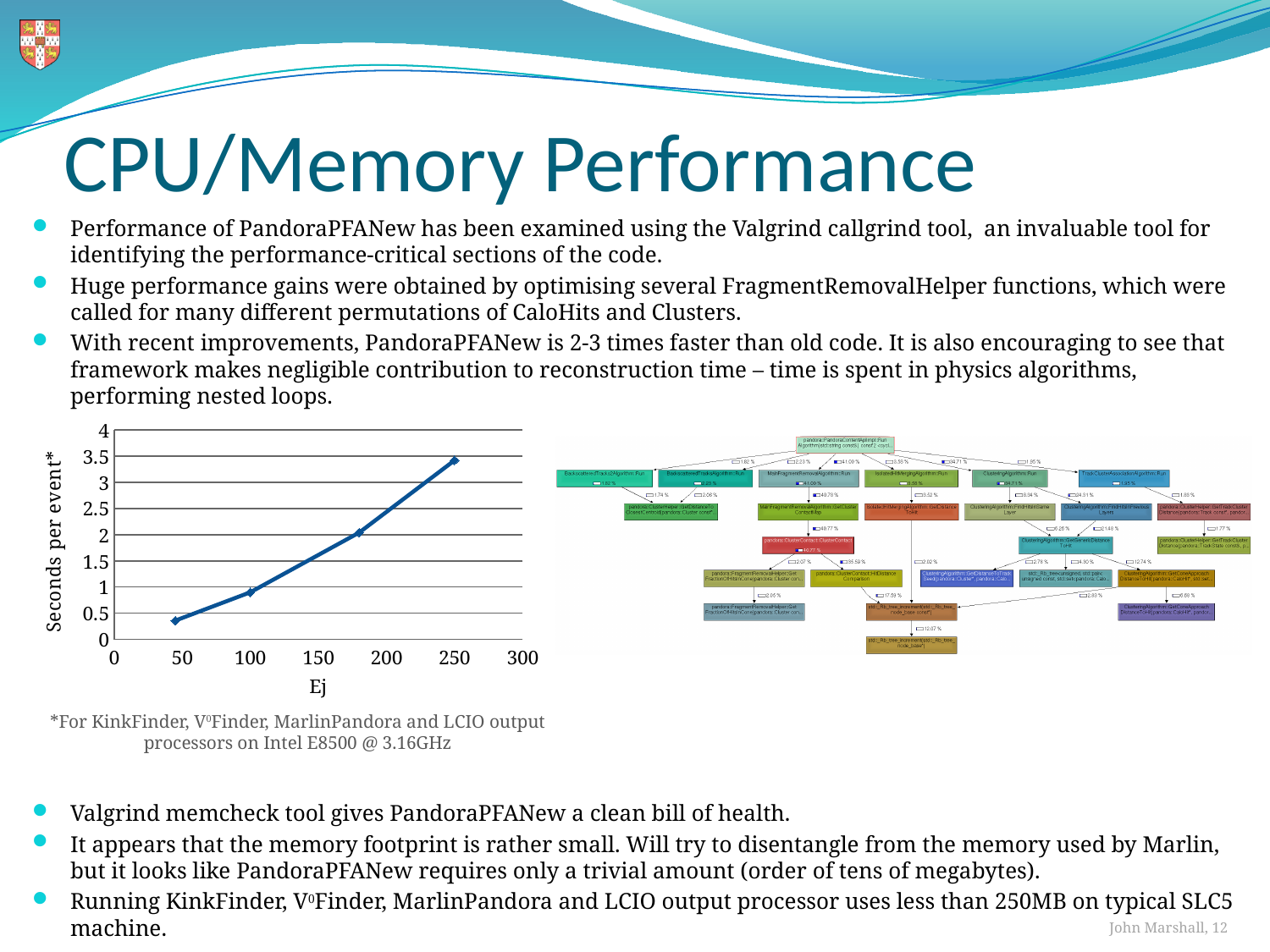
What is the label on the y axis of the left chart? Seconds per event* What kind of chart is the chart on the left of the slide (Seconds per event* vs Ej)? line chart In the left chart, is the value for the point near Ej = 100 greater or less than 1.5? less What is the label on the x axis of the left chart? Ej In the left chart, is the value for the point near Ej = 50 greater or less than 1? less In the left chart, which point has the highest Seconds per event value, the one near Ej = 50 or the one near Ej = 250? the one near Ej = 250 In the left chart, is the value for the point near Ej = 250 greater or less than 3? greater How many data points are plotted in the left chart? 4 In the left chart, do the values rise or fall as Ej increases along the x axis? rise